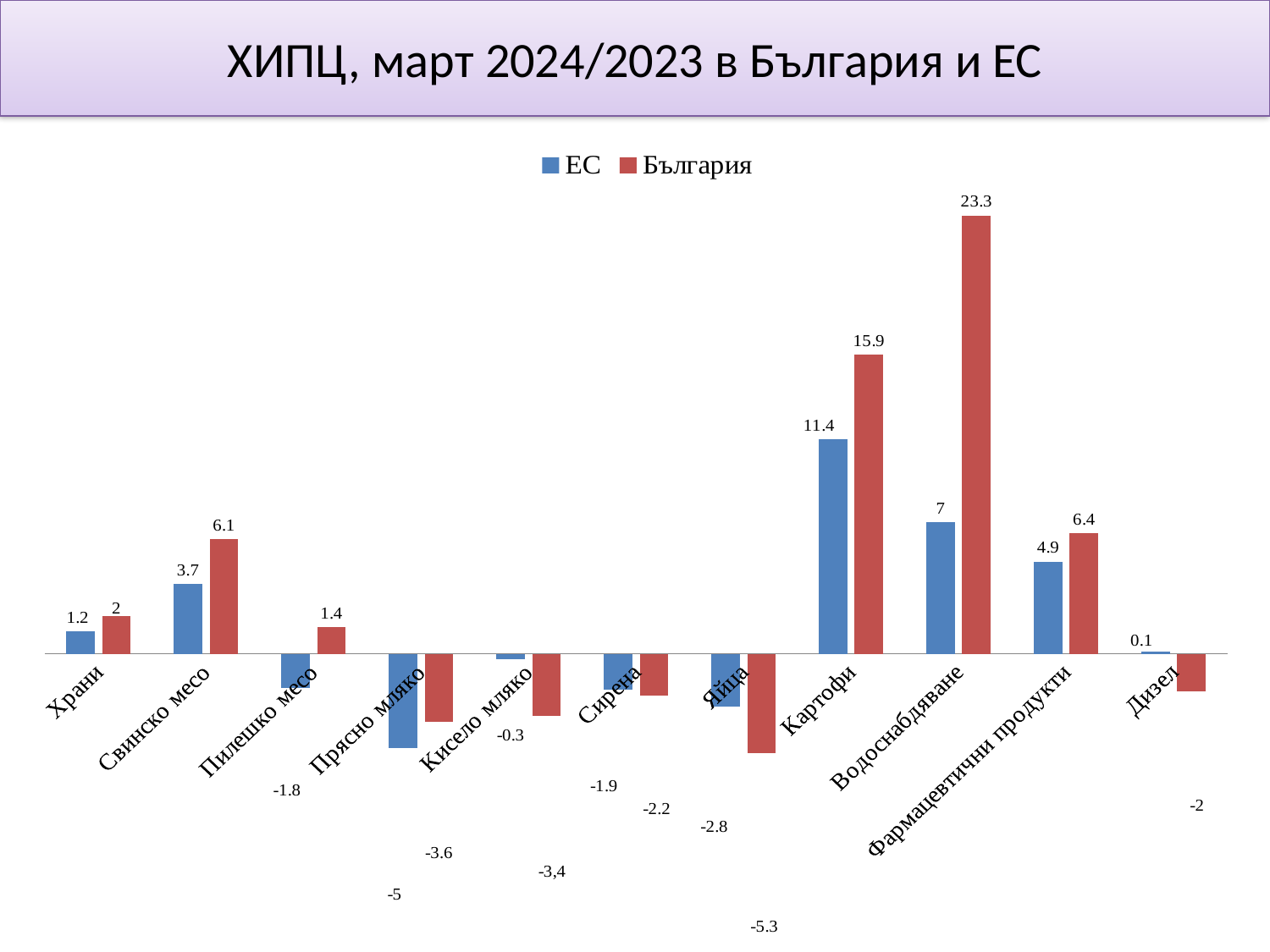
What is the value for България for Водоснабдяване? 23.3 What is the value for ЕС for Картофи? 11.4 What kind of chart is shown on the slide? Bar chart How many series does the legend list? 2 What is the value for България for Свинско месо? 6.1 Which category has the highest value for България? Водоснабдяване What is the difference between the България and ЕС values for Картофи? 4.5 What is the value for ЕС for Фармацевтични продукти? 4.9 What is the title of the slide? ХИПЦ, март 2024/2023 в България и ЕС Which is larger for Водоснабдяване, the ЕС value or the България value? България How many categories are shown on the x axis? 11 Which category has the lowest value for ЕС? Прясно мляко